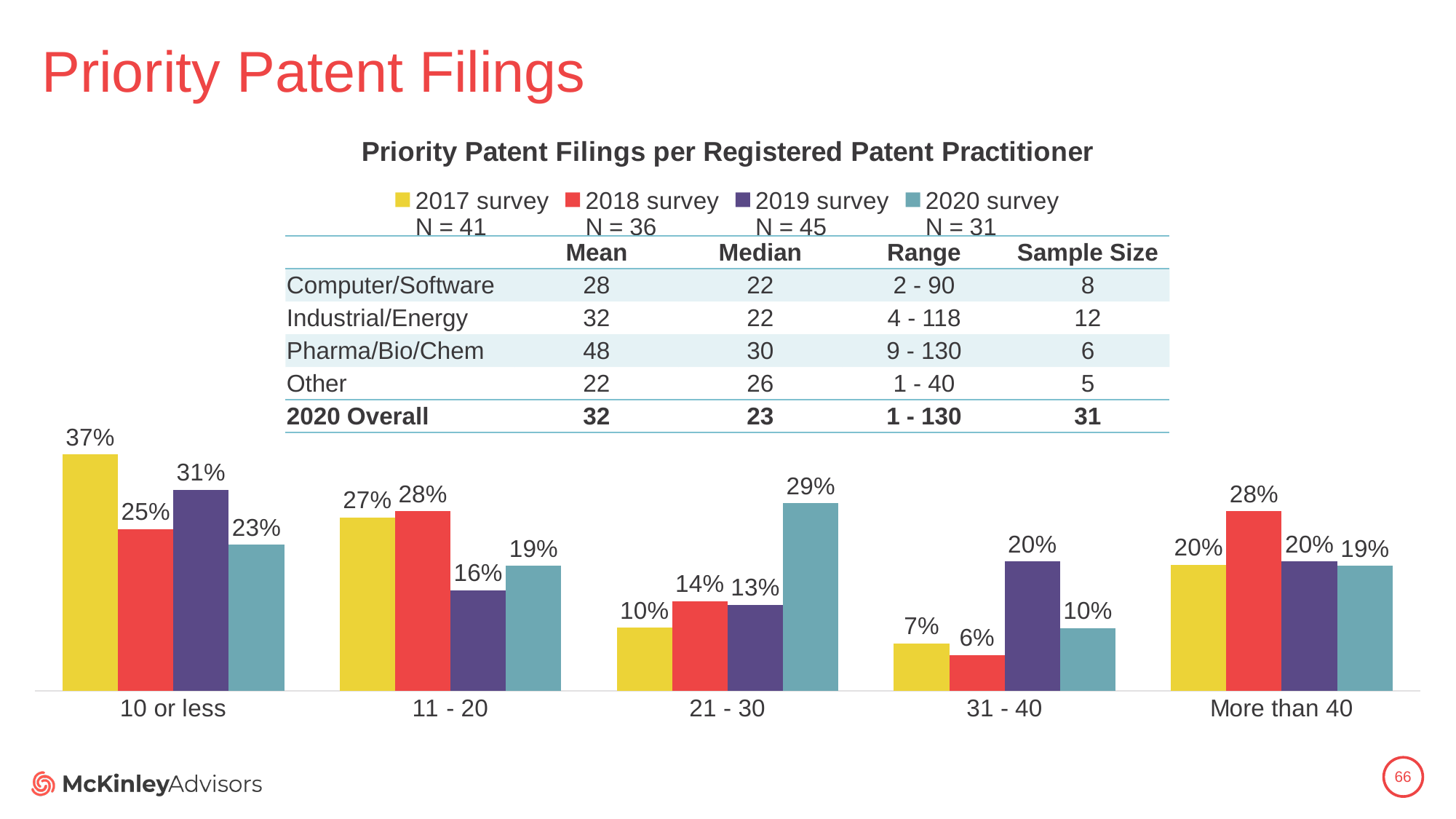
What is the value for the 2017 survey in the '10 or less' category? 37% Which category has the lowest value for the 2018 survey? 31 - 40 What is the value for the 2018 survey in the '31 - 40' category? 6% How many series does the chart legend list? 4 What is the difference between the 2017 survey and 2020 survey values in the '10 or less' category? 14% What is the value for the 2019 survey in the 'More than 40' category? 20% What is the title of the chart? Priority Patent Filings per Registered Patent Practitioner Which category has the highest value for the 2017 survey? 10 or less In the '21 - 30' category, which is larger: the 2017 survey value or the 2020 survey value? 2020 survey What kind of chart is shown on the slide? Bar chart How many categories are shown on the x axis of the chart? 5 What is the value for the 2020 survey in the '21 - 30' category? 29%